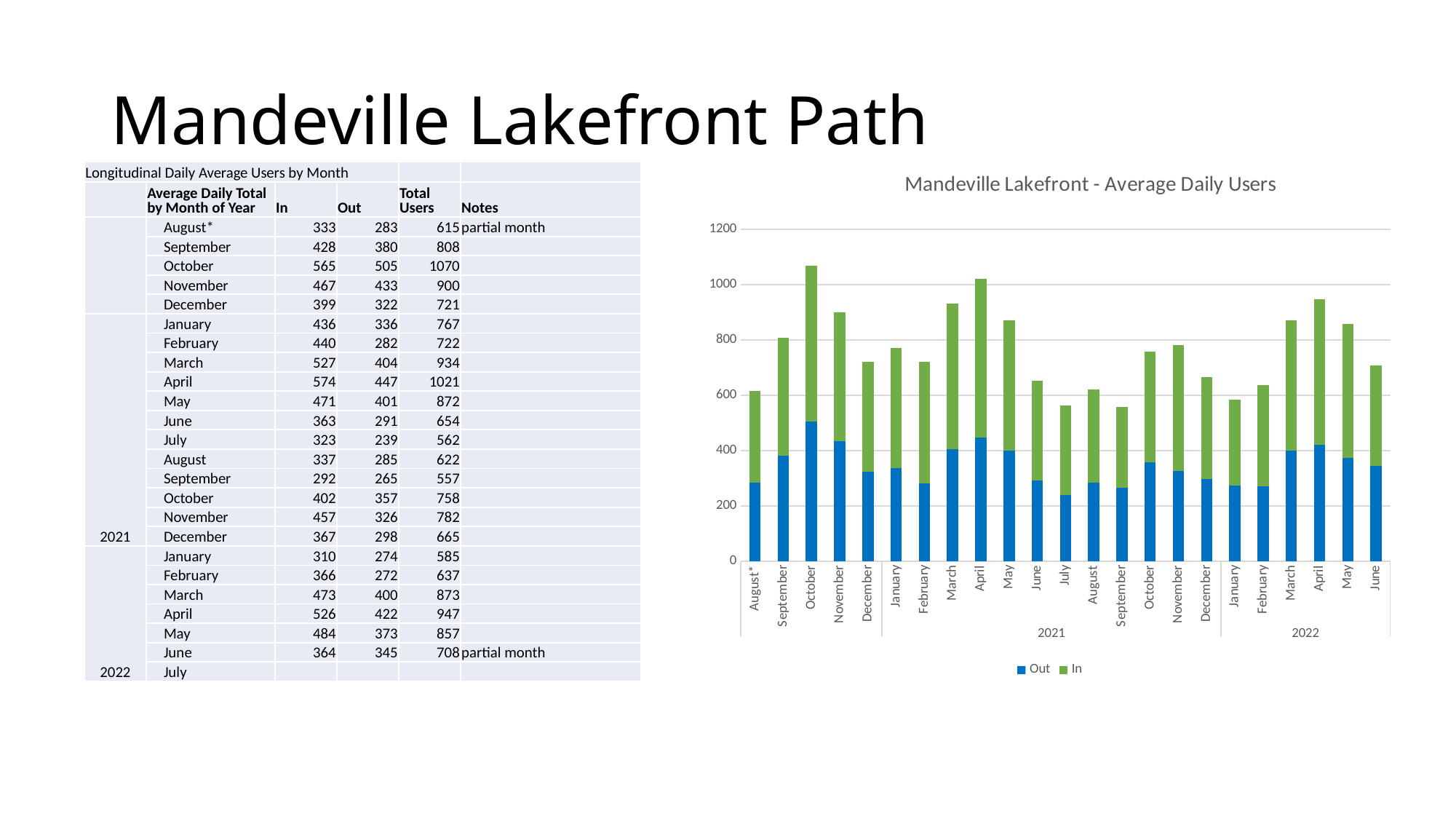
How many monthly bars are plotted in the chart? 23 Is the total value for July 2021 greater or less than 600? less Which month has the highest total average daily users in the chart? October (first year shown) Which is larger, the total for April 2021 or the total for April 2022? April 2021 What is the title of the chart? Mandeville Lakefront - Average Daily Users What kind of chart is shown on the slide? Stacked bar chart Do the total values rise or fall from January 2022 to April 2022? Rise How many series does the chart legend list? 2 According to the table, what is the Total Users value for October in the first year shown? 1070 According to the table, what is the In value for April 2021? 574 Is the total value for April 2022 greater or less than 800? greater Using the table values, what is the difference in Total Users between October (1070) and September (808) in the first year shown? 262